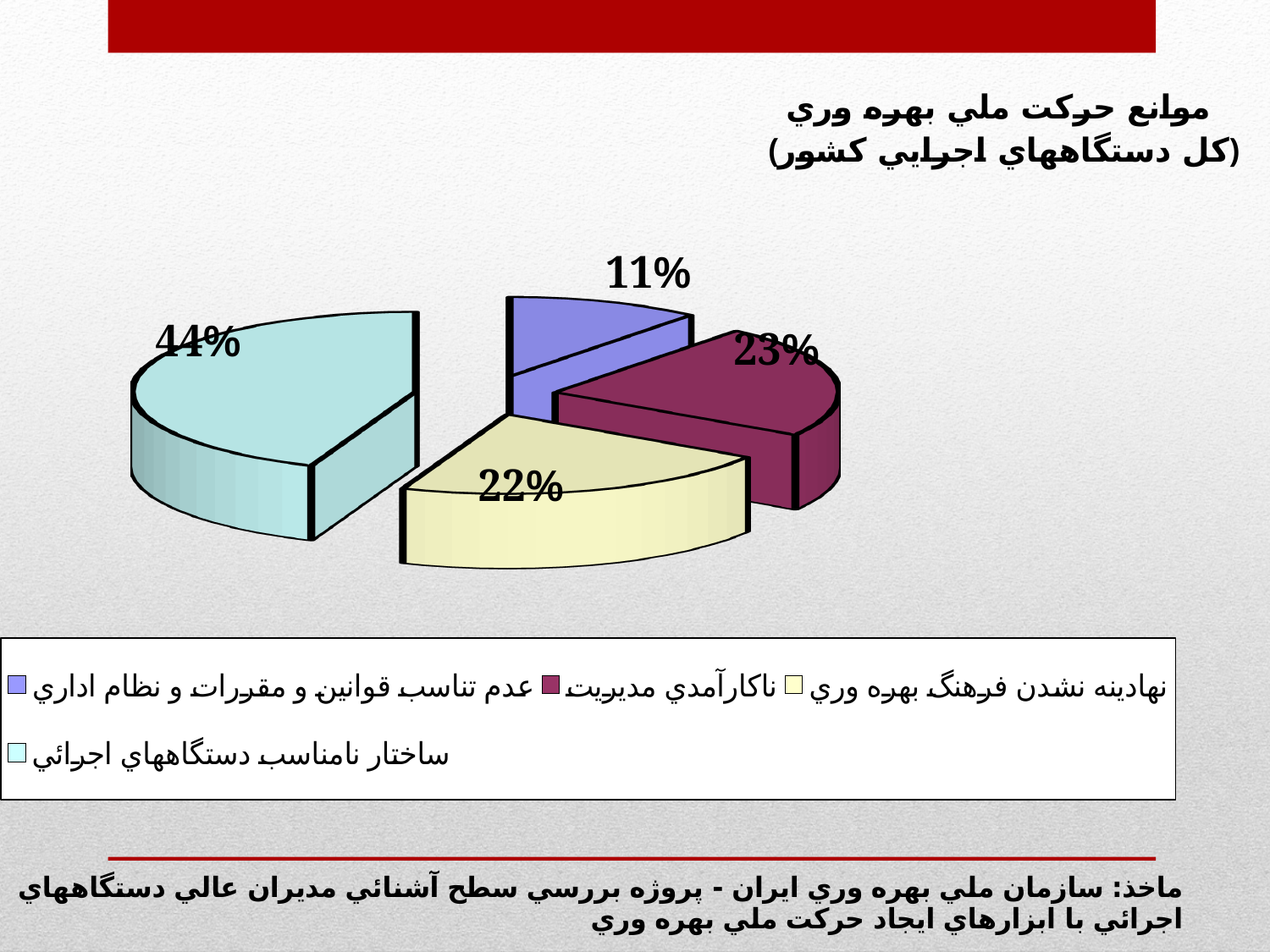
What colour is the slice representing ساختار نامناسب دستگاههاي اجرائي? light cyan What is the difference in percentage points between ساختار نامناسب دستگاههاي اجرائي and عدم تناسب قوانين و مقررات و نظام اداري? 33 What percentage is shown for نهادينه نشدن فرهنگ بهره وري? 22% Which category has the smallest share of the pie? عدم تناسب قوانين و مقررات و نظام اداري How many slices does the pie chart have? 4 What percentage is shown for عدم تناسب قوانين و مقررات و نظام اداري? 11% Which is larger, the share for ناكارآمدي مديريت or the share for عدم تناسب قوانين و مقررات و نظام اداري? ناكارآمدي مديريت How many entries does the legend list? 4 What percentage is shown for ناكارآمدي مديريت? 23% What type of chart is shown on the slide? pie chart Which category has the largest share of the pie? ساختار نامناسب دستگاههاي اجرائي What share of the pie is labelled for ساختار نامناسب دستگاههاي اجرائي? 44%